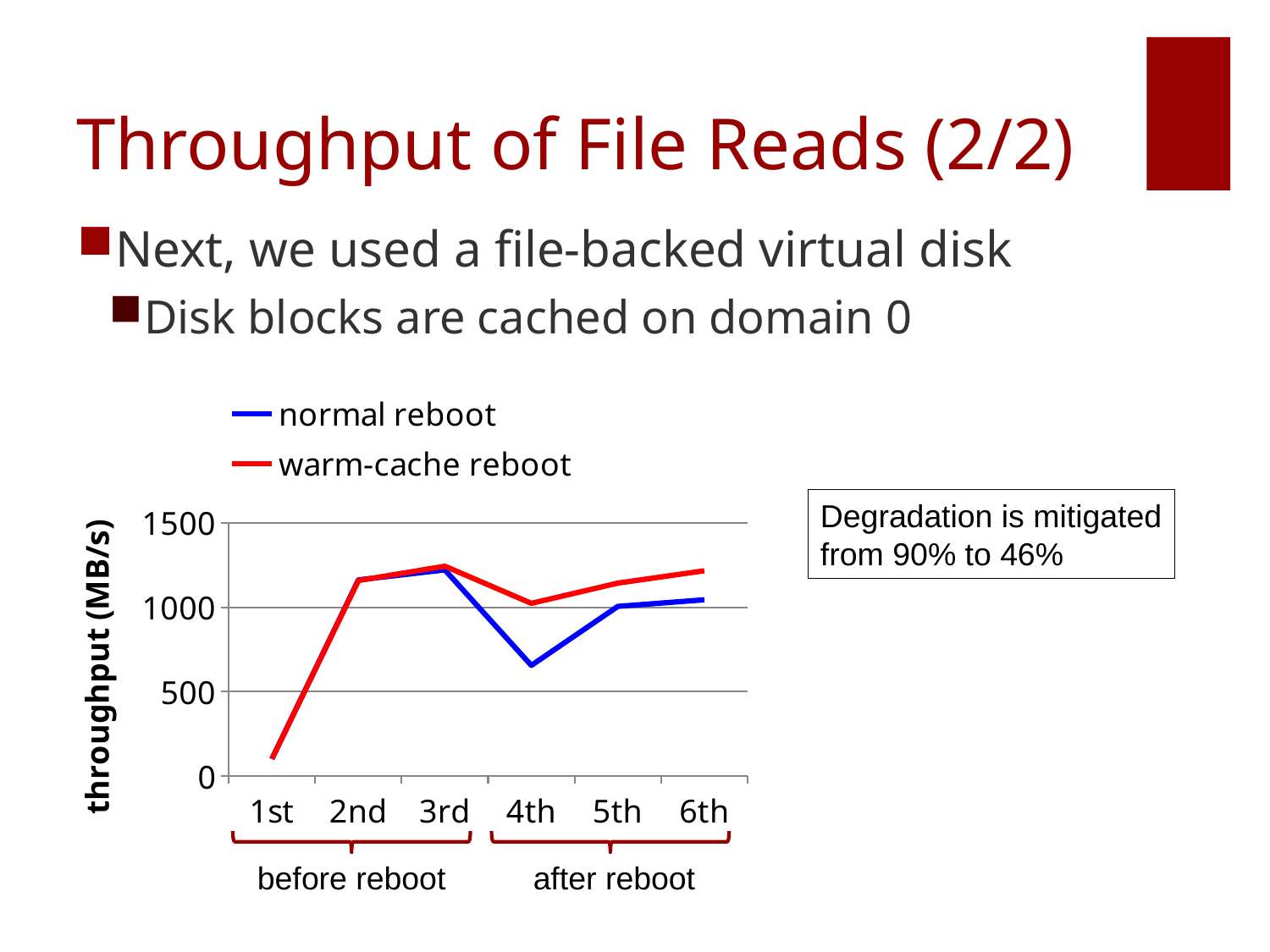
At the 4th read, which series has the higher throughput, normal reboot or warm-cache reboot? warm-cache reboot What is the label of the y axis? throughput (MB/s) Which colour is used for the warm-cache reboot series? red Is the throughput at the 1st read greater or less than 500? less Does the normal reboot throughput rise or fall from the 3rd read to the 4th read? fall What kind of chart is shown on the slide? line chart How many series does the chart legend list? 2 Does the warm-cache reboot throughput rise or fall from the 4th read to the 6th read? rise Is the warm-cache reboot throughput at the 6th read greater or less than 1000? greater Is the normal reboot throughput at the 4th read greater or less than 1000? less How many points are plotted along the x axis for each series? 6 At which read is the normal reboot throughput lowest? 1st